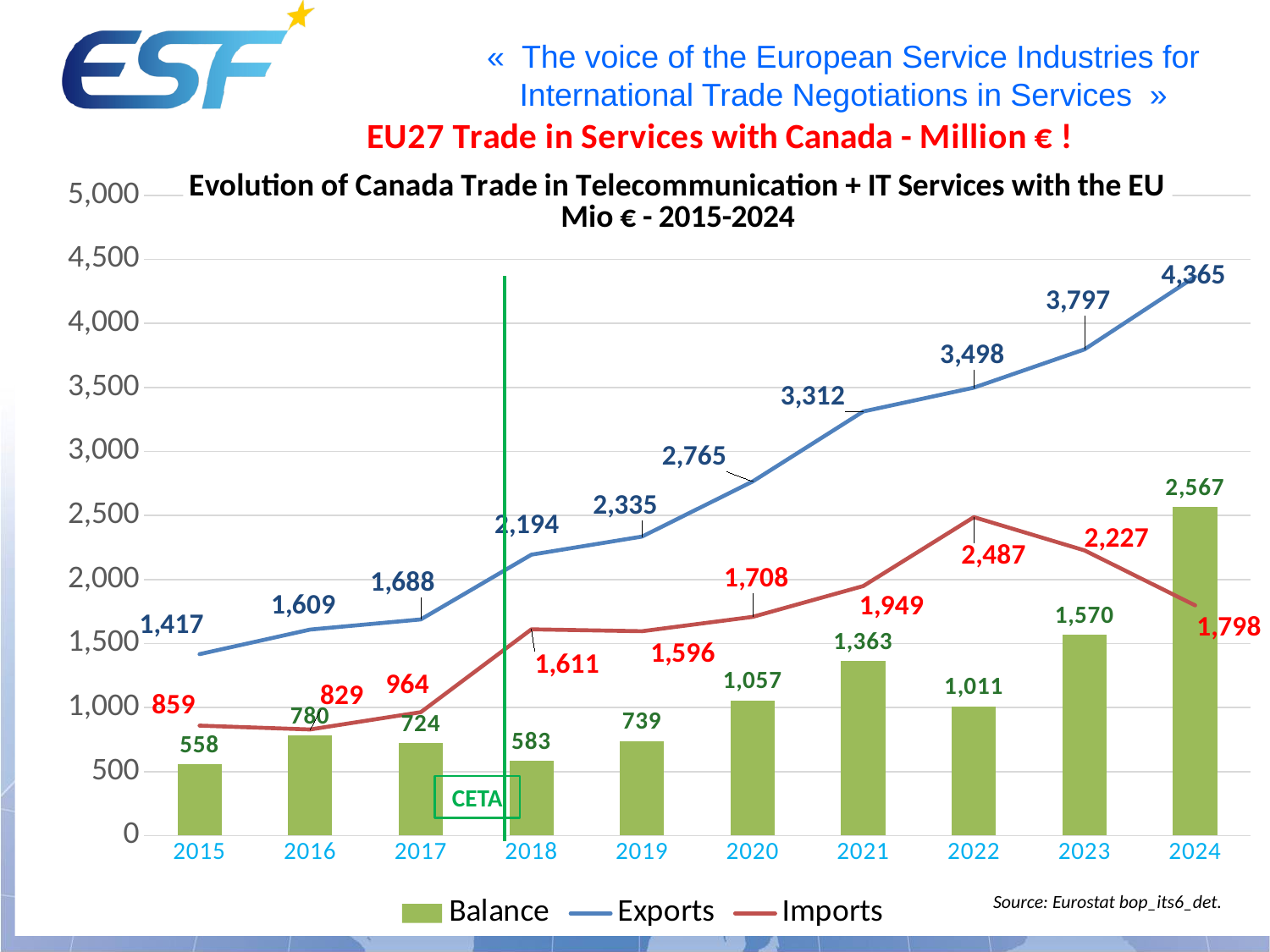
Do the Exports values rise or fall from 2015 to 2024? rise In which year is the Balance bar lowest? 2015 What is the value of Exports in 2024? 4,365 Which is larger in 2016: Imports or Balance? Imports What is the value of Imports in 2018? 1,611 What is the difference between Exports and Imports in 2022? 1,011 What is the Balance value shown for 2021? 1,363 How many years are shown on the x axis? 10 Which series is drawn as green bars? Balance Is the Exports value for 2020 greater or less than 2,500? greater In which year is the Imports value highest? 2022 How many series does the legend list? 3